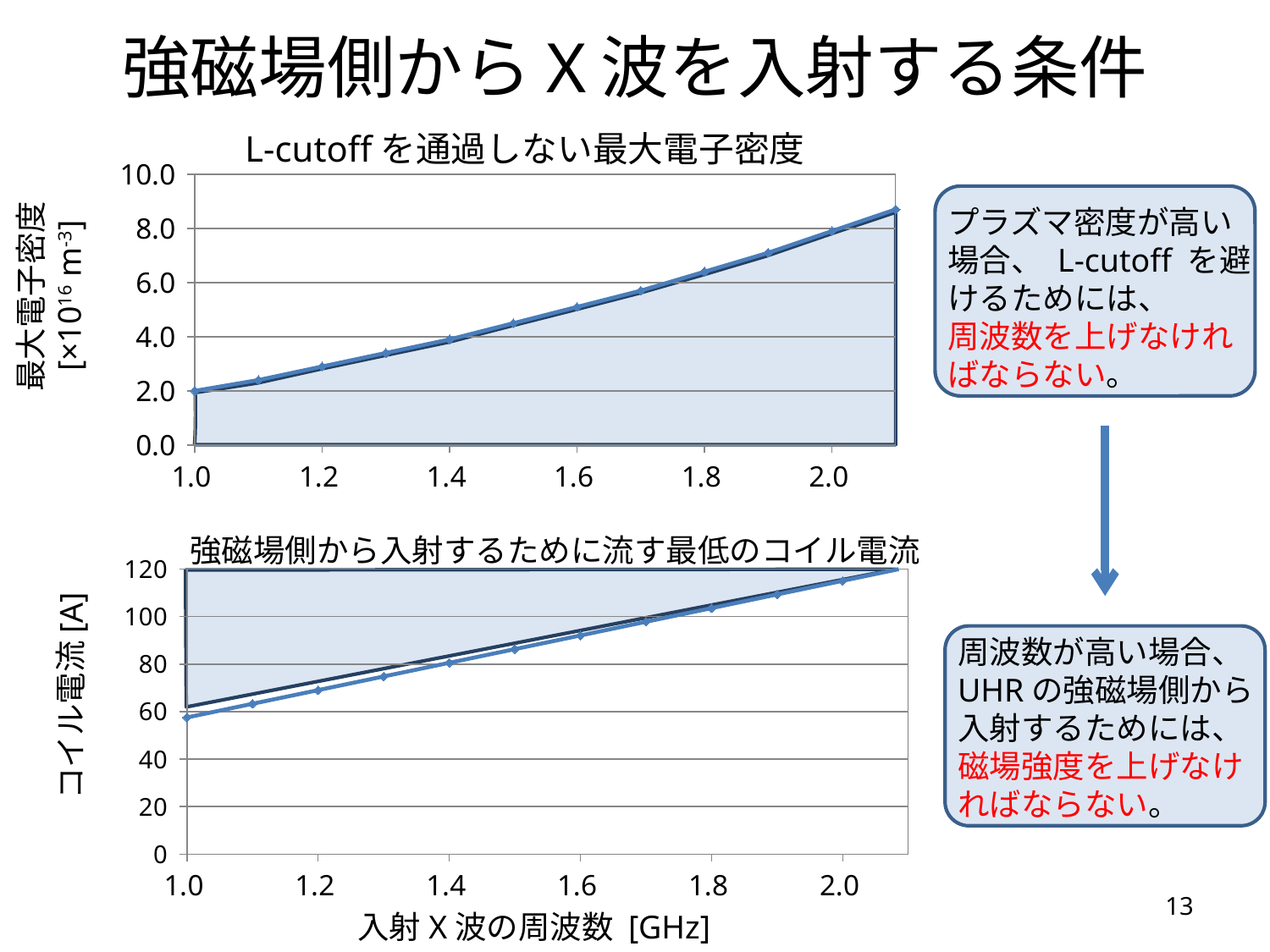
In the top chart 'L-cutoffを通過しない最大電子密度', is the value at 1.6 GHz greater or less than 8.0? less What is the y-axis label of the bottom chart? コイル電流 [A] In the bottom chart, which frequency has the higher coil current, 1.2 GHz or 1.8 GHz? 1.8 GHz In the top chart 'L-cutoffを通過しない最大電子密度', is the value at 1.4 GHz greater or less than 6.0? less In the bottom chart '強磁場側から入射するために流す最低のコイル電流', is the value at 2.0 GHz greater or less than 100? greater In the bottom chart '強磁場側から入射するために流す最低のコイル電流', do the values rise or fall as the frequency increases along the x axis? rise In the top chart 'L-cutoffを通過しない最大電子密度', do the values rise or fall as the frequency increases along the x axis? rise What kind of chart is the top chart titled 'L-cutoffを通過しない最大電子密度'? line chart What is the x-axis label shown under the bottom chart? 入射X波の周波数 [GHz]